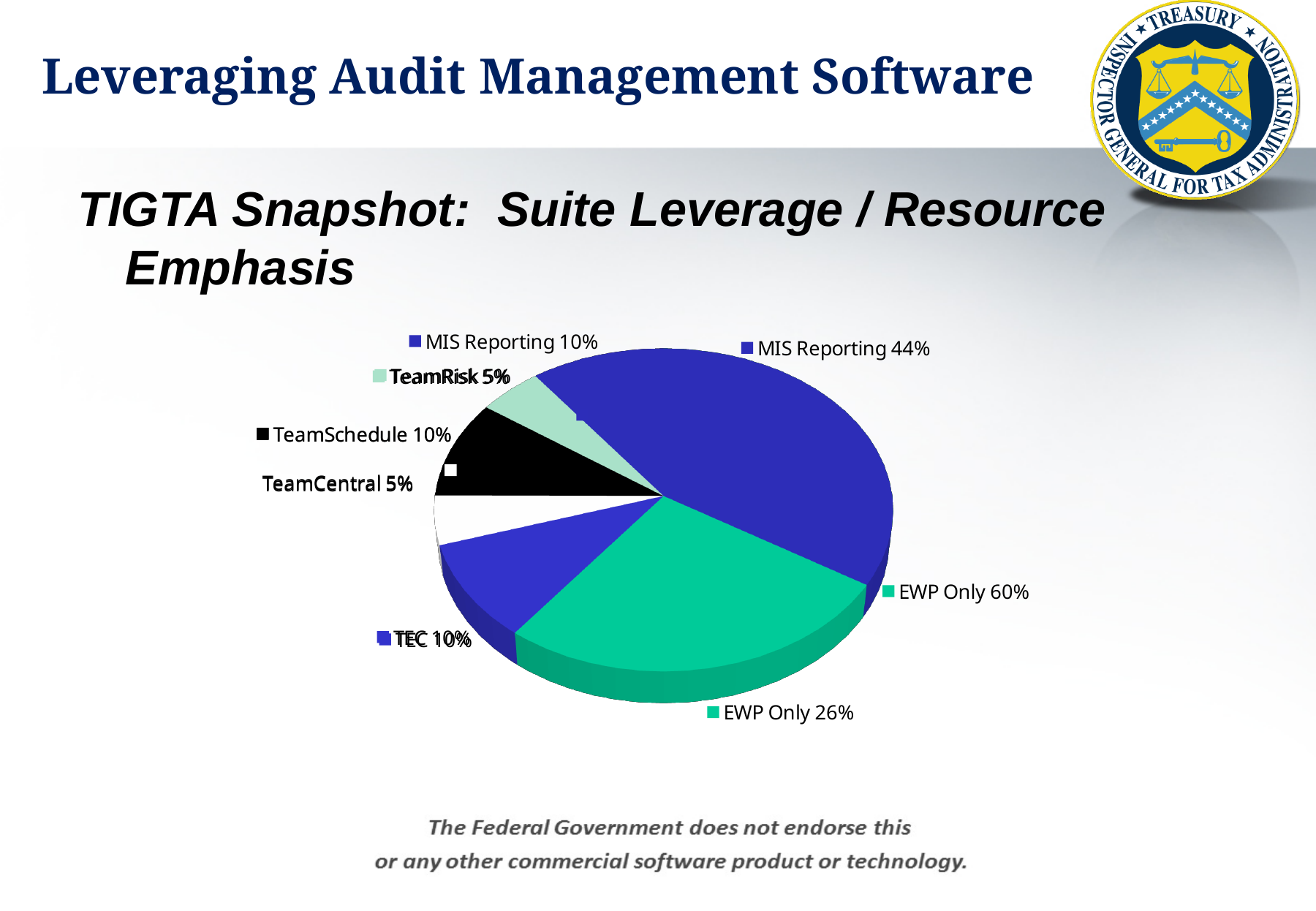
What percentage is shown for TeamRisk in the pie chart? 5% What colour is the TeamSchedule slice in the pie chart? black What percentage is shown for TEC in the pie chart? 10% What is the difference in percentage points between TEC and TeamCentral in the pie chart? 5% Which is larger in the pie chart, TeamSchedule or TeamRisk? TeamSchedule What is the heading above the pie chart? TIGTA Snapshot: Suite Leverage / Resource Emphasis What kind of chart is shown on the slide? pie chart What percentage is shown for TeamSchedule in the pie chart? 10% How many slices does the pie chart have? 6 What percentage is shown for TeamCentral in the pie chart? 5%